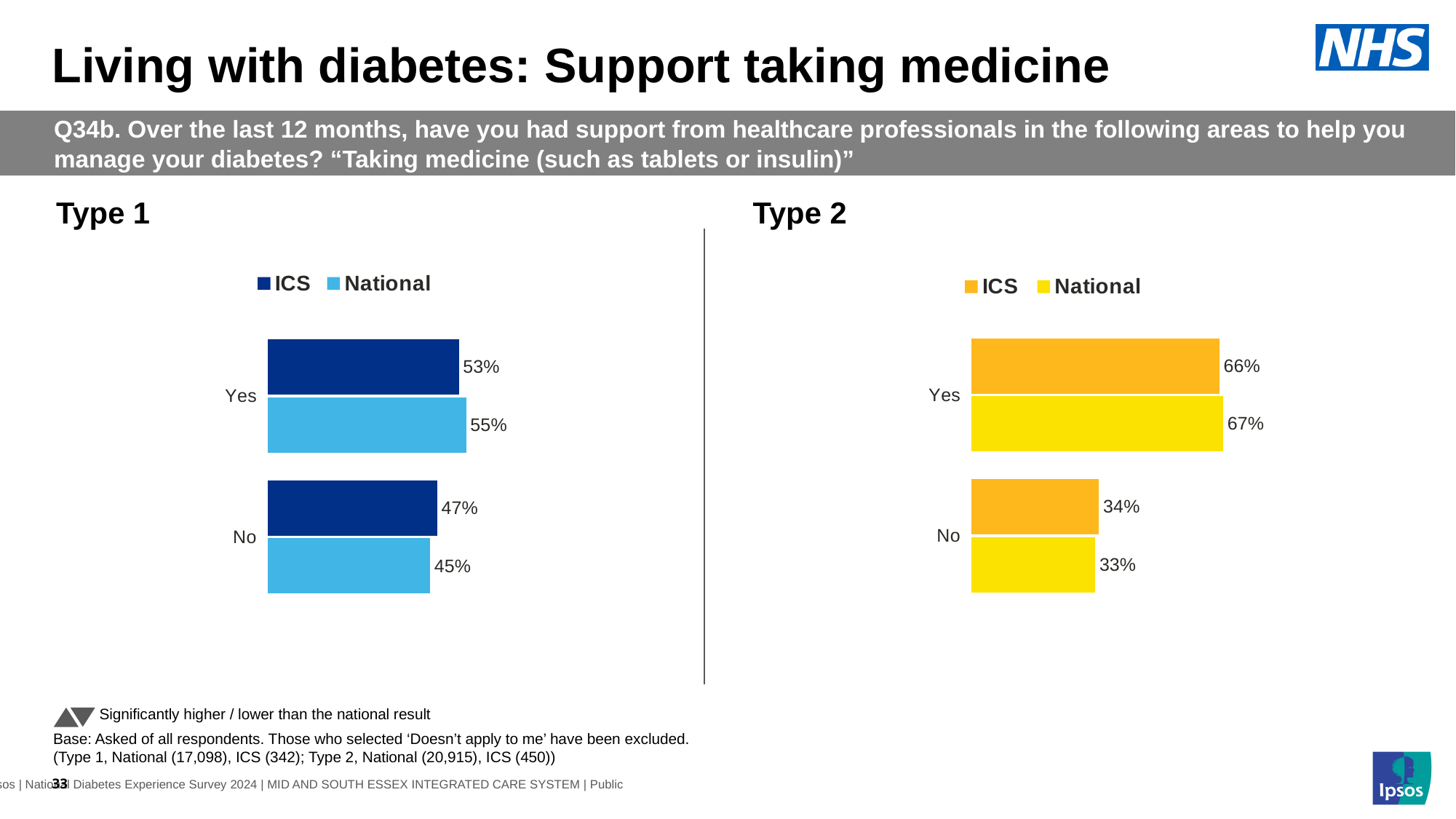
In the Type 2 chart, what is the National value for No? 33% How many series does the legend of the Type 2 chart list? 2 In the Type 2 chart, what is the difference between the ICS values for Yes and No? 32% In the Type 2 chart, what is the ICS value for Yes? 66% What kind of chart is the Type 2 chart? Bar chart In the Type 1 chart, which category has the lowest ICS value? No In the Type 1 chart, what is the difference between the National and ICS values for Yes? 2% In the Type 2 chart, which category has the highest National value? Yes In the Type 1 chart, what is the National value for No? 45% In the Type 1 chart, what is the ICS value for Yes? 53% In the Type 1 chart, which is larger for No: the ICS value or the National value? ICS How many categories are shown in the Type 1 chart? 2